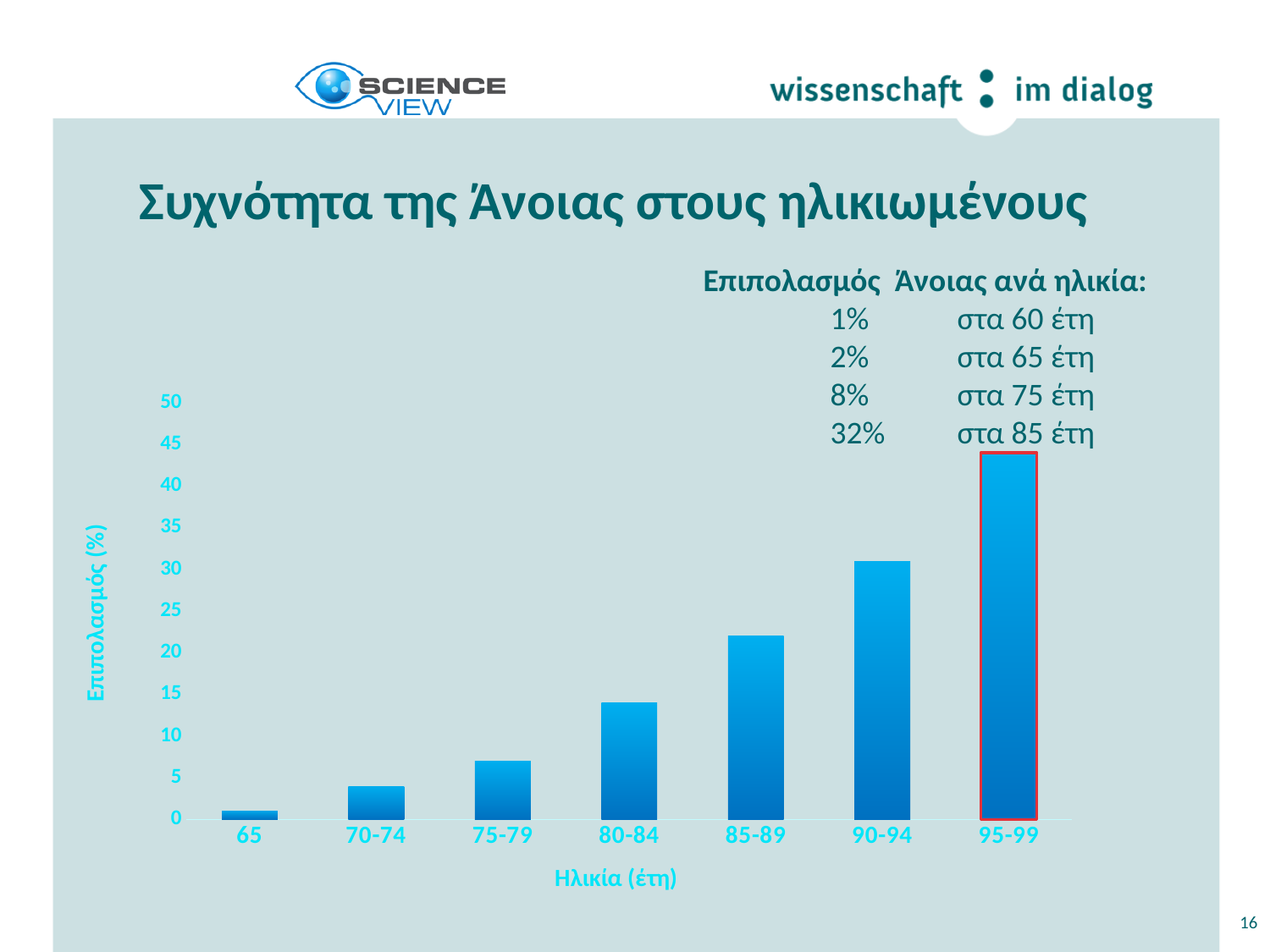
Do the values rise or fall as age increases along the x axis? rise Is the value for the 75-79 age group greater or less than 10? less Which age group has the lowest prevalence in the chart? 65 What kind of chart is shown on the slide? bar chart Is the value for the 85-89 age group greater or less than 25? less Is the value for the 90-94 age group greater or less than 35? less Which has a larger value, the 85-89 age group or the 80-84 age group? 85-89 How many age categories are shown on the x axis of the chart? 7 What is the label of the y axis of the chart? Επιπολασμός (%) Which age group has the highest prevalence in the chart? 95-99